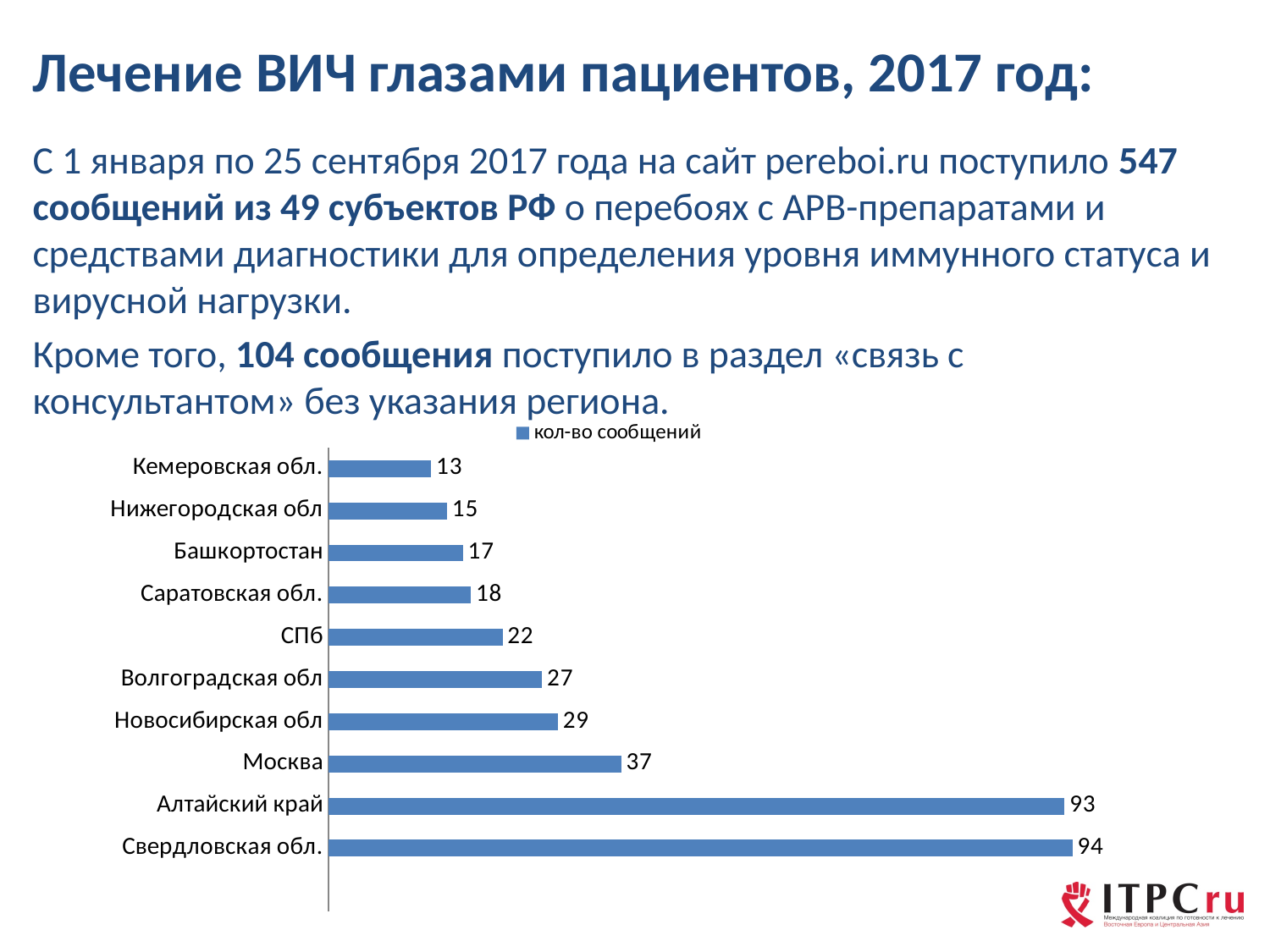
What is the difference between the values for Волгоградская обл and Нижегородская обл? 12 How many categories are shown in the chart? 10 Which is larger, the value for Новосибирская обл or the value for Башкортостан? Новосибирская обл Which category has the lowest value? Кемеровская обл. What is the value for Саратовская обл.? 18 What is the legend entry of the chart? кол-во сообщений Which category has the highest value? Свердловская обл. How many series does the legend list? 1 What is the value for СПб? 22 What kind of chart is shown on the slide? bar chart What is the difference between the values for Алтайский край and Москва? 56 What is the value for Москва? 37